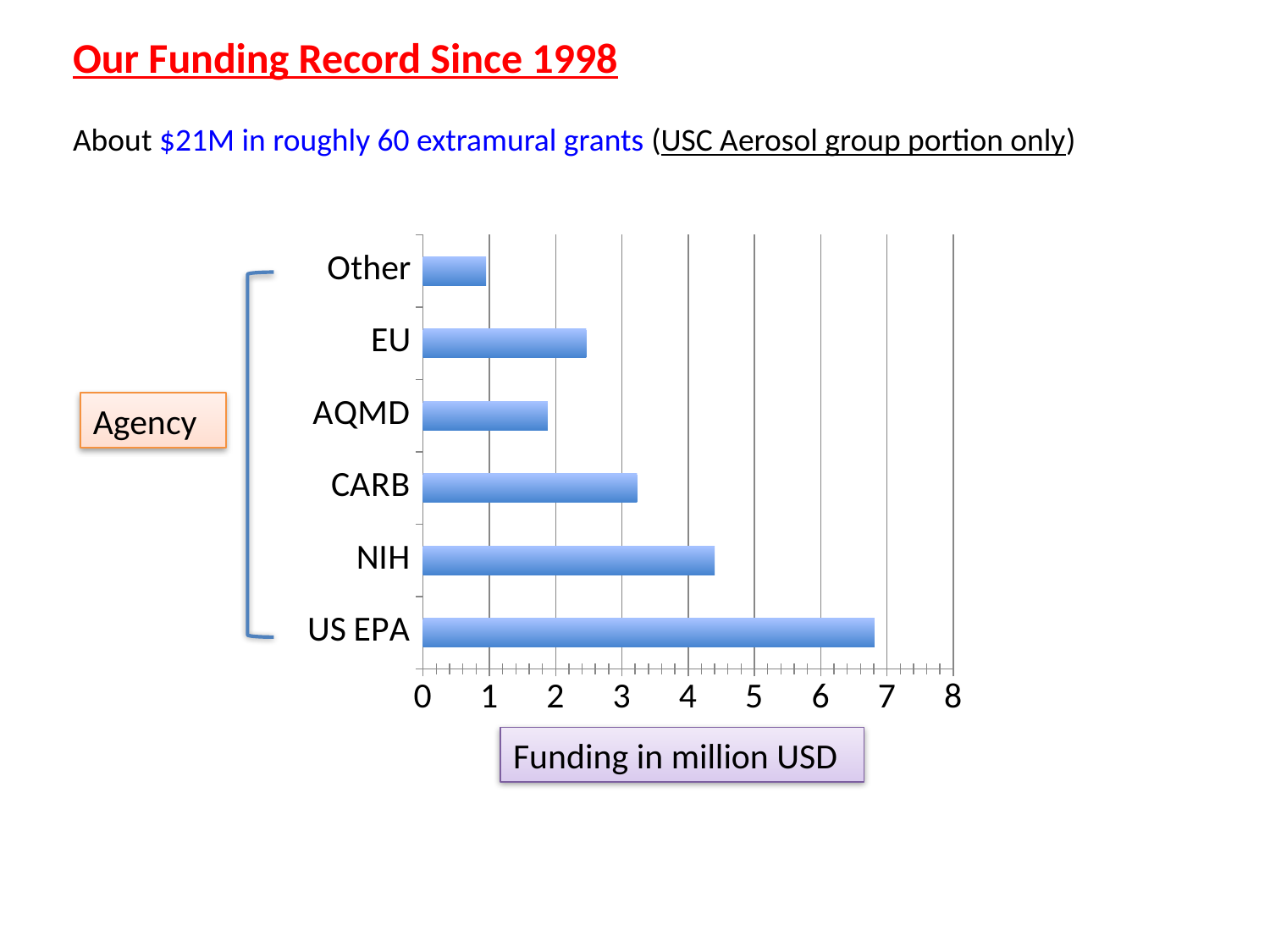
What kind of chart is shown on the slide? bar chart Which has more funding, EU or AQMD? EU Is the value for EU greater or less than 3? less Is the value for CARB greater or less than 4? less Is the value for NIH greater or less than 4? greater Which has more funding, NIH or CARB? NIH What unit is the horizontal axis labelled with? Funding in million USD Which agency has the highest funding? US EPA How many agencies are shown in the chart? 6 Which agency has the lowest funding? Other